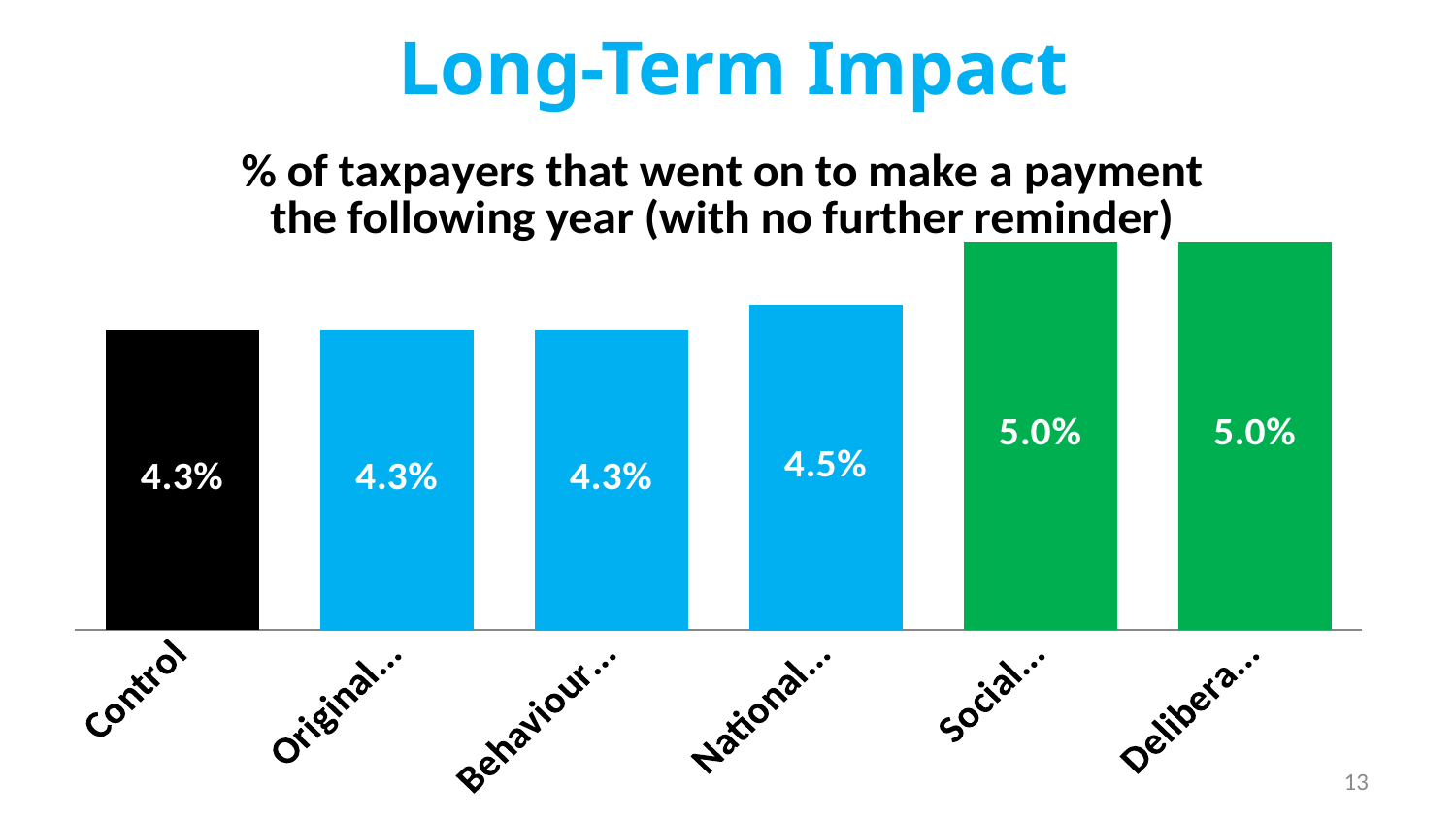
How many bars are plotted in the chart? 6 What is the value for Control? 4.3% What is the highest value shown in the chart? 5.0% What is the difference between the value of the rightmost bar (5.0%) and the Control bar? 0.7% What is the value of the rightmost bar (labelled 'Delibera...')? 5.0% Which is larger, the value for Control or the value of the fifth bar from the left ('Social...')? Social... What is the lowest value shown in the chart? 4.3% What is the difference between the fourth bar from the left ('National...') and the Control bar? 0.2% What is the value of the fourth bar from the left (labelled 'National...')? 4.5% What colour is the Control bar? black What kind of chart is shown on the slide? bar chart What is the subtitle describing what the chart measures? % of taxpayers that went on to make a payment the following year (with no further reminder)